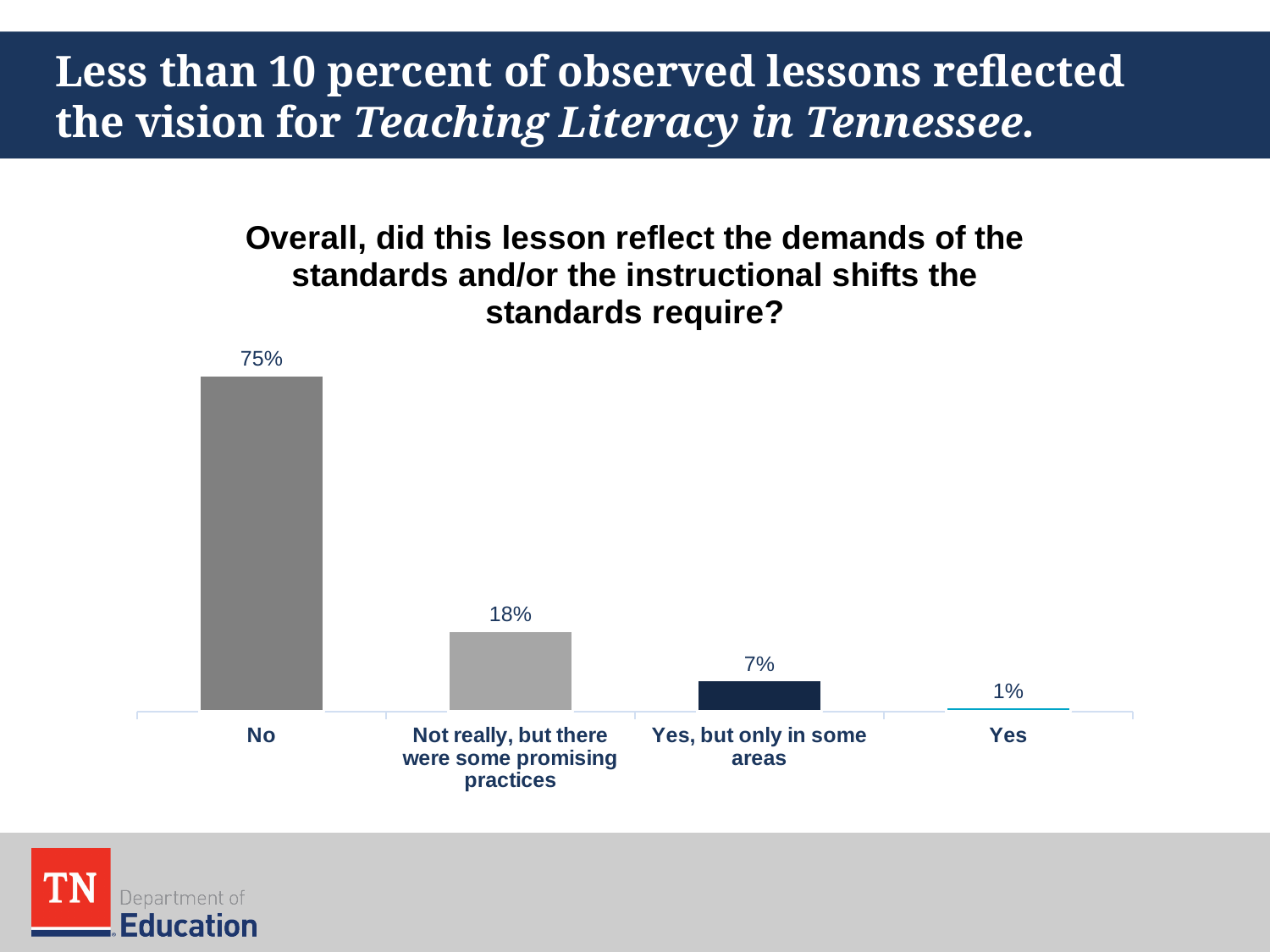
What percentage of lessons were rated "Yes, but only in some areas"? 7% What percentage of lessons were rated "No"? 75% What is the difference in percentage points between the "No" and "Not really, but there were some promising practices" categories? 57 Do the values rise or fall moving from left to right across the categories? Fall What is the difference in percentage points between "Yes, but only in some areas" and "Yes"? 6 What percentage of lessons were rated "Yes"? 1% What percentage of lessons were rated "Not really, but there were some promising practices"? 18% How many response categories are shown on the chart? 4 Which response category has the highest percentage? No Which is larger: the percentage for "Not really, but there were some promising practices" or for "Yes, but only in some areas"? Not really, but there were some promising practices What type of chart is shown on the slide? Bar chart Which response category has the lowest percentage? Yes